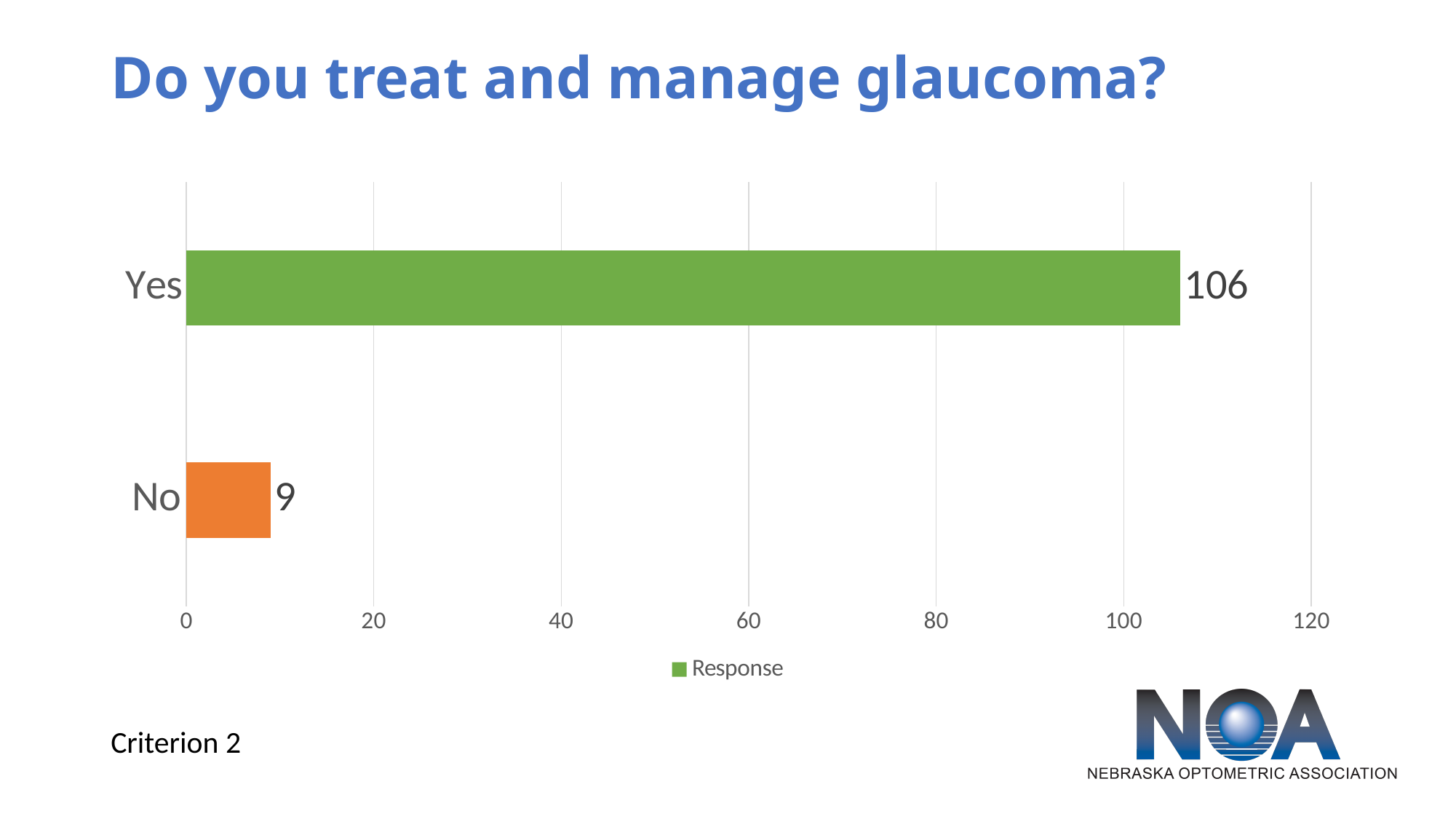
Which is larger, the value for Yes or the value for No? Yes What is the value for No? 9 Is the value for No greater or less than 20? less What is the title of the chart? Do you treat and manage glaucoma? How many series does the legend list? 1 Is the value for Yes greater or less than 100? greater How many categories are shown in the chart? 2 What is the difference between the values for Yes and No? 97 What is the value for Yes? 106 What kind of chart is shown on the slide? bar chart Which category has the lowest value? No Which category has the highest value? Yes